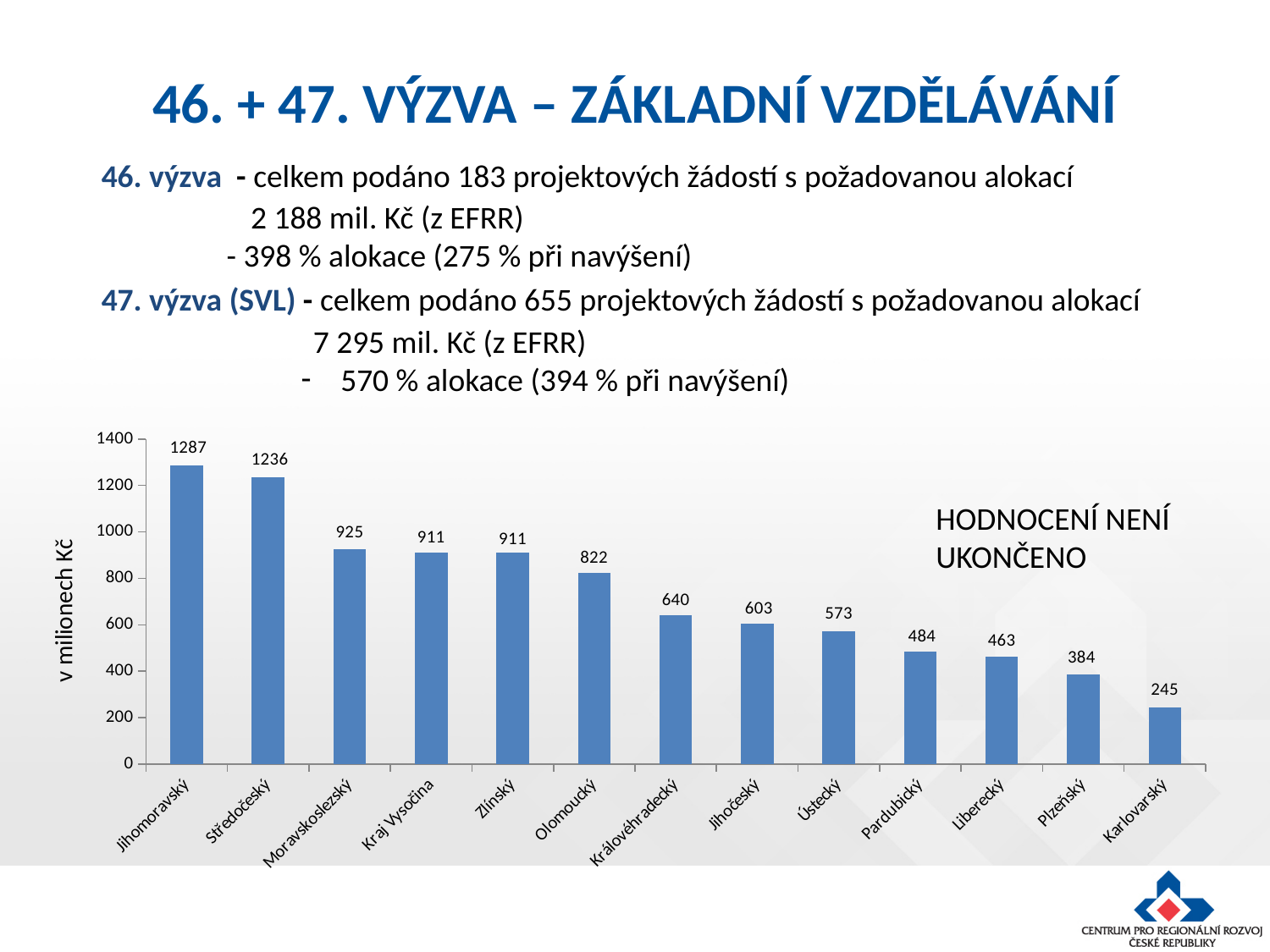
What kind of chart is shown on the slide? bar chart How many categories are shown on the x axis? 13 What is the value for Jihomoravský? 1287 Which is larger, the value for Královéhradecký or the value for Ústecký? Královéhradecký Which category has the lowest value? Karlovarský What is the difference between the values for Moravskoslezský and Plzeňský? 541 What is the value for Olomoucký? 822 Which category has the highest value? Jihomoravský Is the value for Pardubický greater or less than 400? greater What is the label of the vertical axis? v milionech Kč What is the difference between the values for Jihomoravský and Středočeský? 51 What is the value for Karlovarský? 245